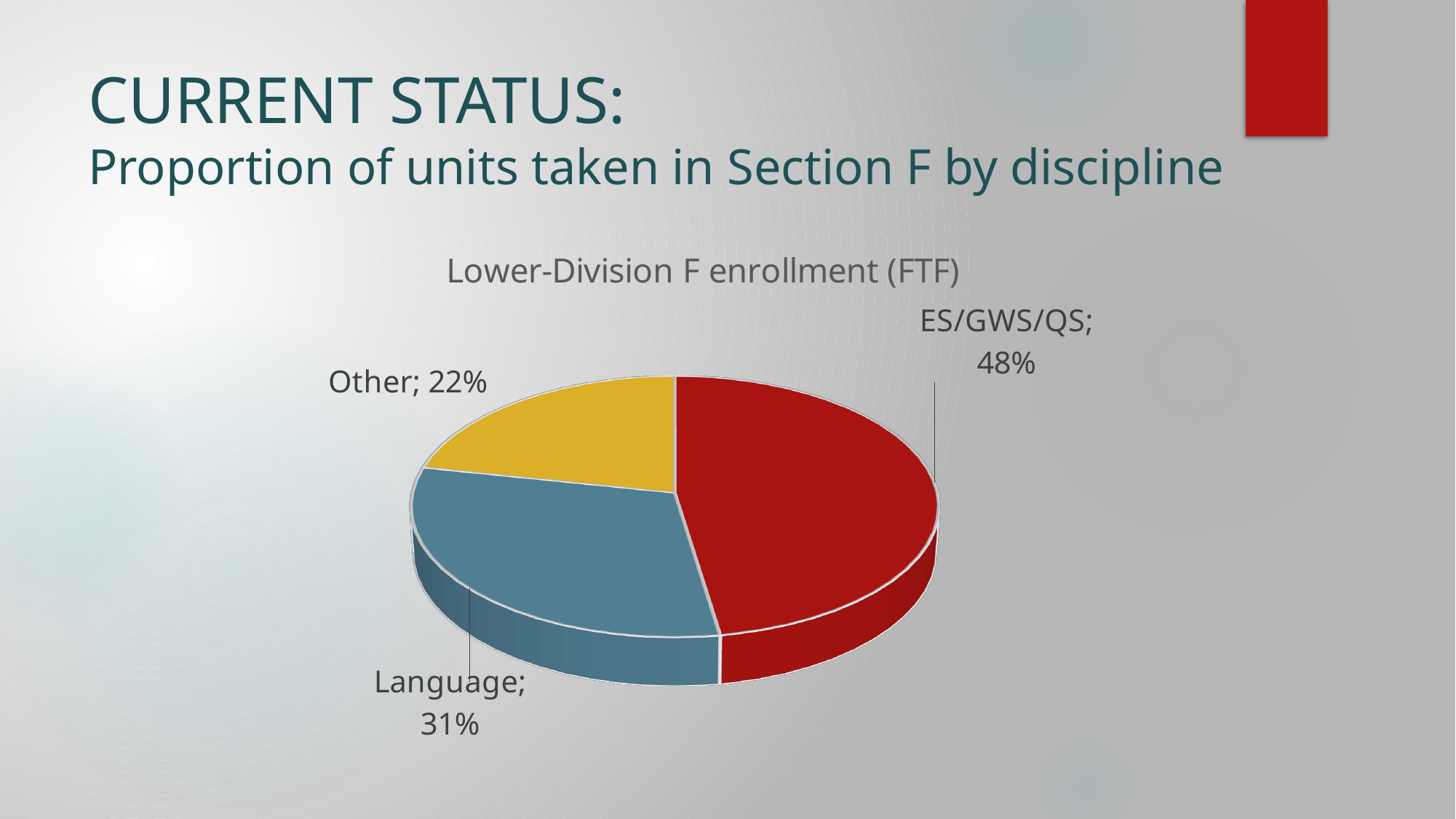
Which is larger, the share for Language or the share for Other? Language What is the difference in percentage points between ES/GWS/QS and Language? 17 Which category has the largest share of the pie? ES/GWS/QS What share of the pie does Other represent? 22% What share of the pie does Language represent? 31% What is the title of the chart? Lower-Division F enrollment (FTF) What share of the pie does ES/GWS/QS represent? 48% How many categories are shown in the pie chart? 3 What type of chart is shown on the slide? Pie chart Which category has the smallest share of the pie? Other What colour is the ES/GWS/QS slice? Red What is the difference in percentage points between Language and Other? 9